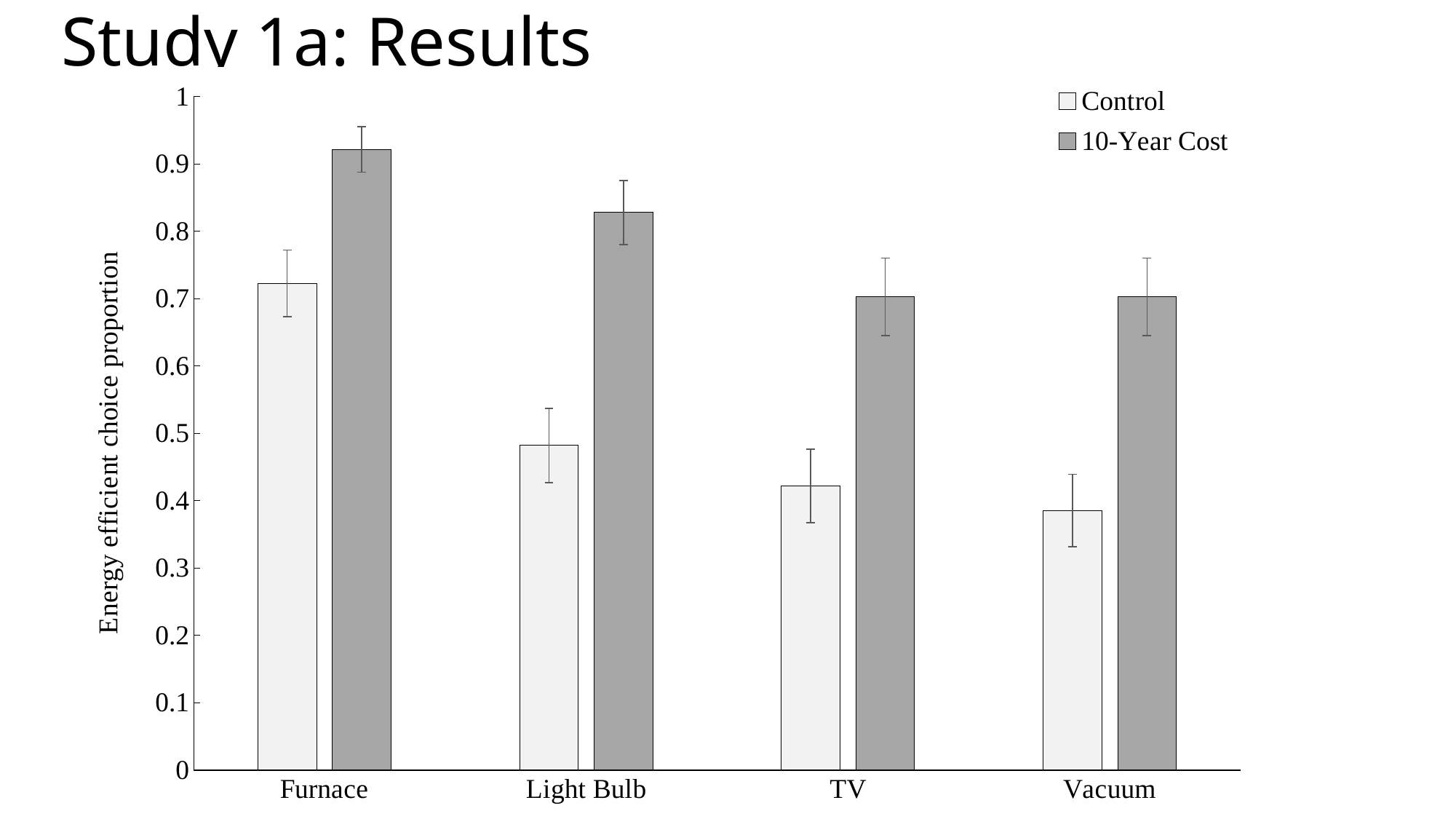
How many series does the legend list? 2 Is the Control value for Furnace greater or less than 0.6? greater Is the Control value for TV greater or less than 0.5? less Is the 10-Year Cost value for Light Bulb greater or less than 0.8? greater Which is larger: the Control value for Furnace or the Control value for Light Bulb? Furnace What is the label on the y axis? Energy efficient choice proportion How many product categories are shown on the x axis? 4 Which category has the highest 10-Year Cost bar? Furnace What kind of chart is shown on the slide? bar chart Which category has the lowest Control bar? Vacuum For Light Bulb, which is larger: the Control bar or the 10-Year Cost bar? 10-Year Cost